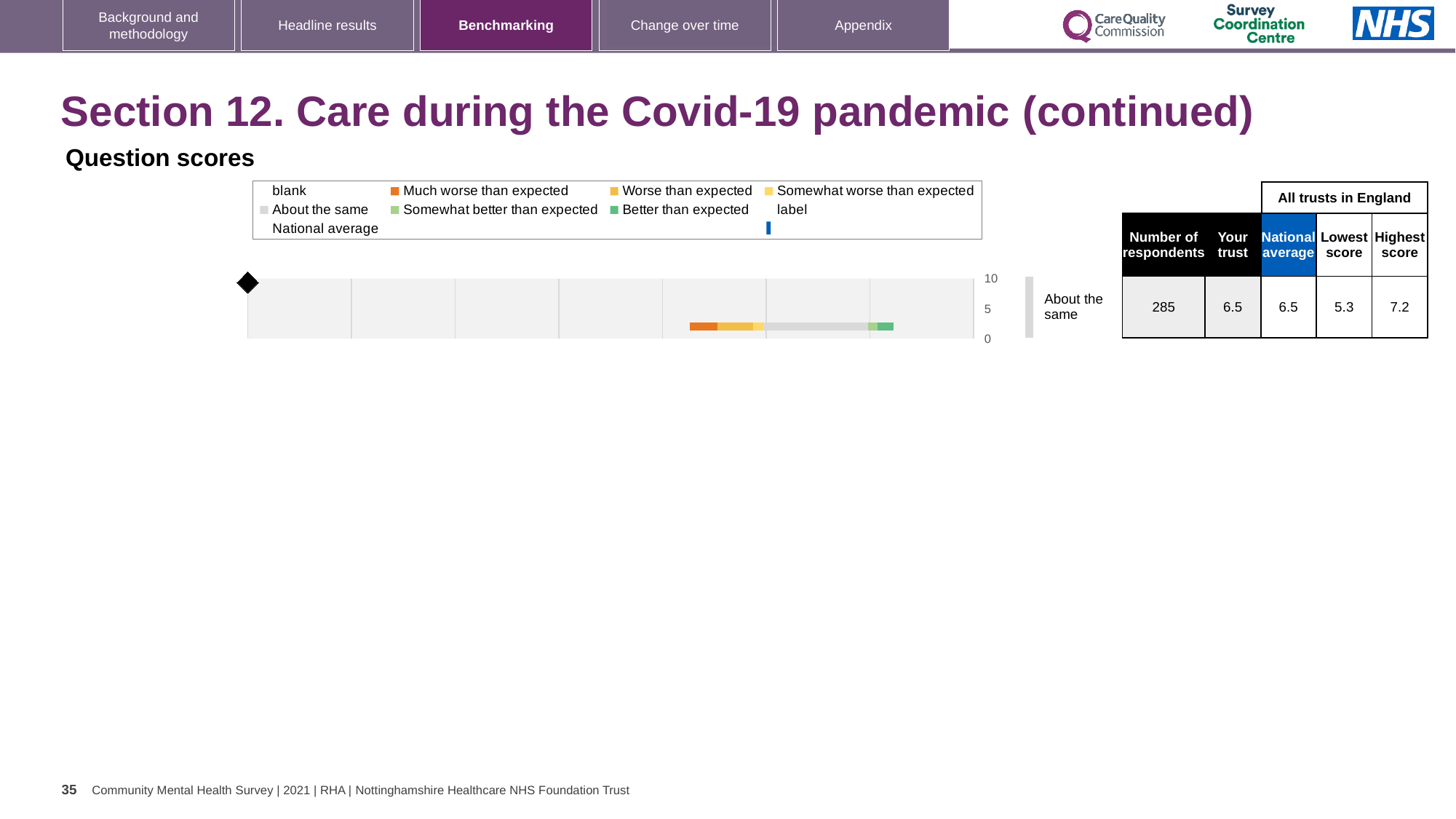
Is the "Your trust" score higher than, lower than, or the same as the national average for the "About the same" row? the same Is the highest score for the "About the same" row greater or less than 5? greater What is the heading above the chart? Question scores What is the highest score among all trusts in England for the "About the same" row? 7.2 What is the lowest score among all trusts in England for the "About the same" row? 5.3 What is the "Your trust" score for the "About the same" row? 6.5 Which legend entry is shown in orange? Much worse than expected What is the national average score for the "About the same" row? 6.5 What kind of chart is shown under "Question scores"? bar chart How many question rows are plotted in the chart? 1 What is the difference between the highest score and the lowest score for the "About the same" row? 1.9 What is the number of respondents for the "About the same" row? 285